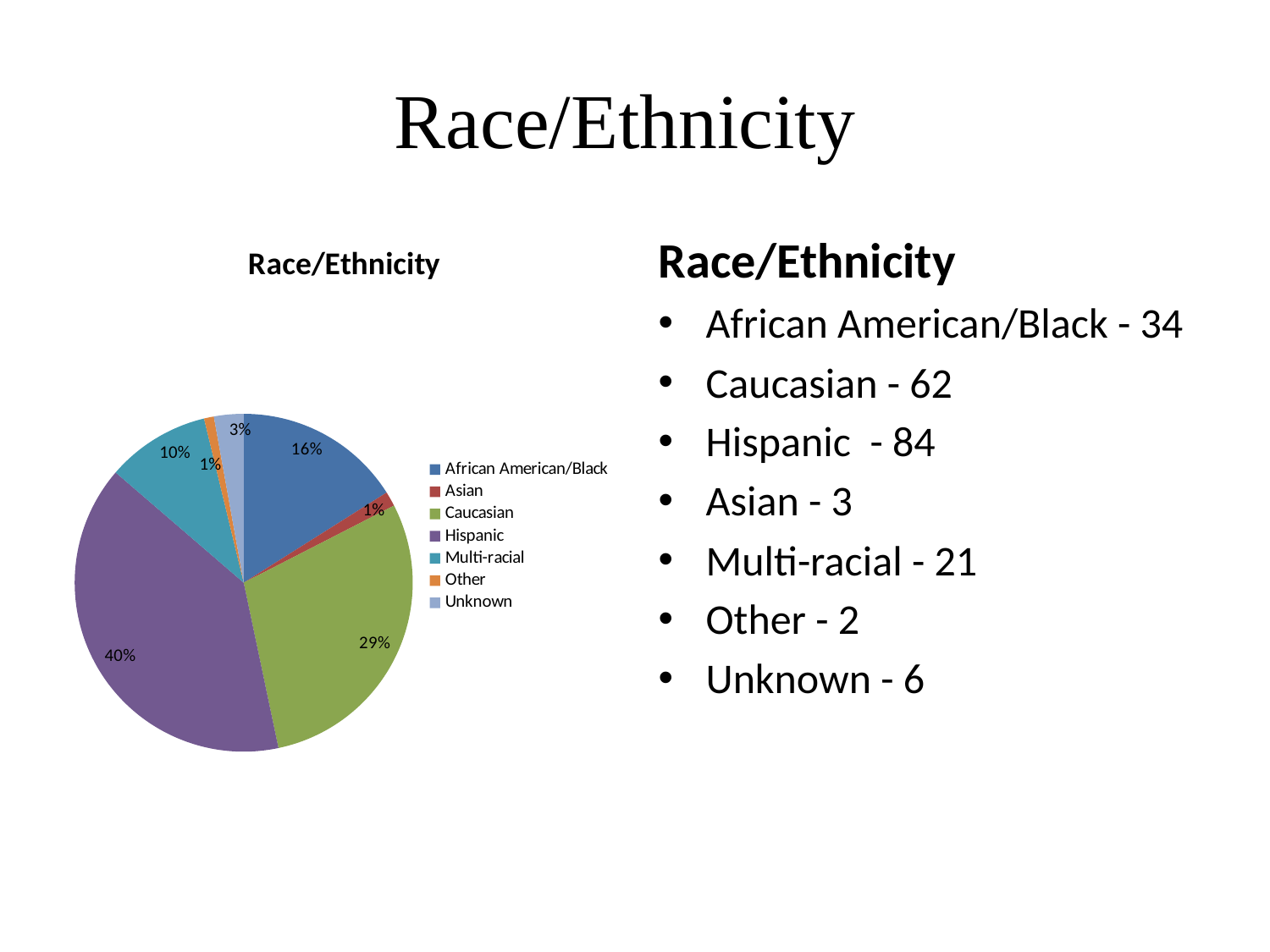
What share of the pie does African American/Black represent? 16% What type of chart is shown on the slide? Pie chart Which category has the largest slice of the pie? Hispanic What share of the pie does Unknown represent? 3% What is the difference in percentage points between the Hispanic slice and the Caucasian slice? 11 percentage points What share of the pie does Caucasian represent? 29% How many categories are shown in the pie chart? 7 Which slice is larger, Caucasian or African American/Black? Caucasian What is the title of the chart? Race/Ethnicity How many entries does the legend list? 7